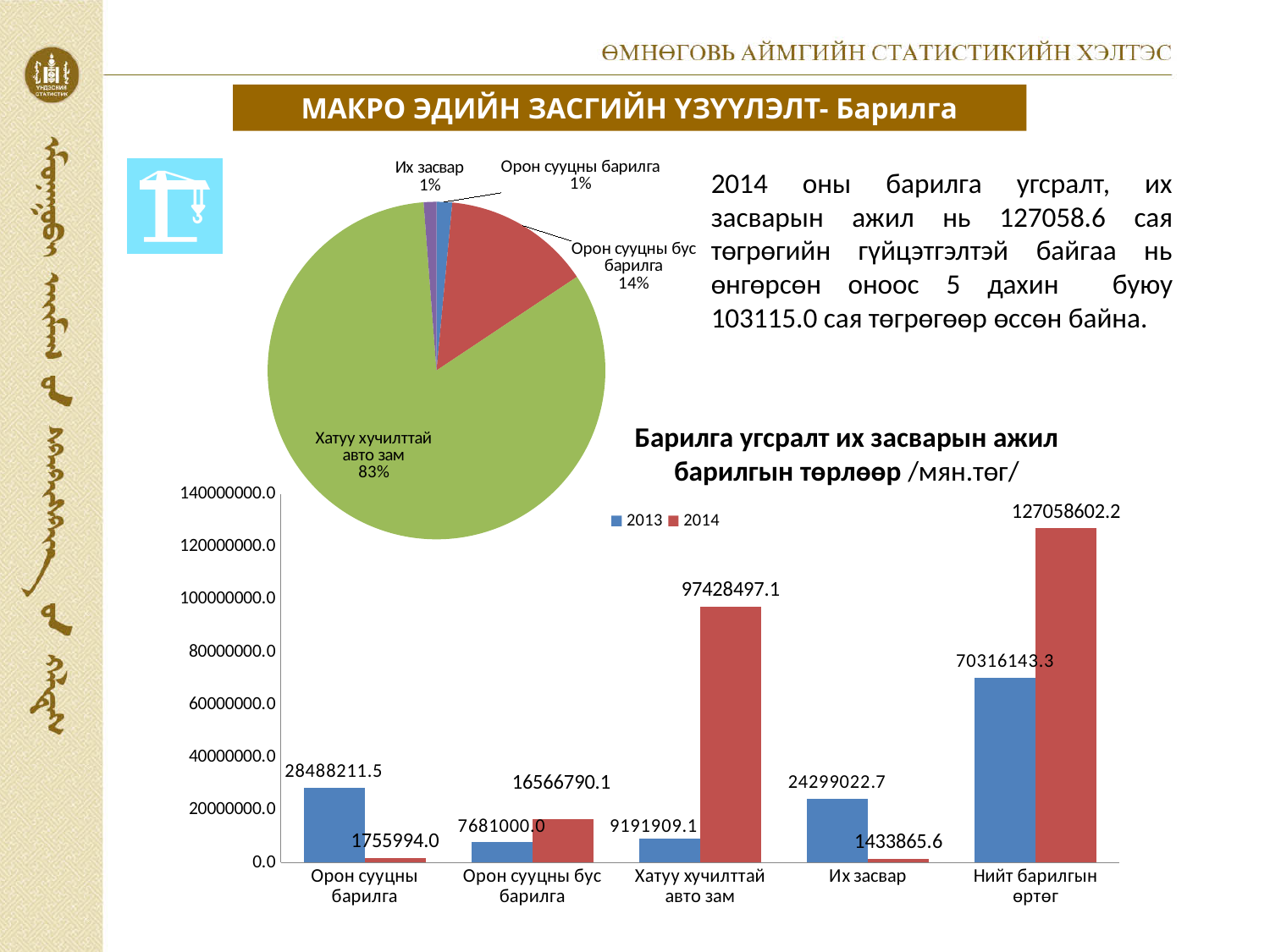
In the bar chart titled 'Барилга угсралт их засварын ажил барилгын төрлөөр', how many series does the legend list? 2 In the bar chart titled 'Барилга угсралт их засварын ажил барилгын төрлөөр', which is larger for Орон сууцны барилга: the 2013 value or the 2014 value? 2013 In the pie chart, what share does Орон сууцны бус барилга have? 14% What kind of chart is the one titled 'Барилга угсралт их засварын ажил барилгын төрлөөр'? Bar chart In the pie chart, what share does Хатуу хучилттай авто зам have? 83% In the bar chart titled 'Барилга угсралт их засварын ажил барилгын төрлөөр', what is the difference between the 2014 and 2013 values for Нийт барилгын өртөг? 56742458.9 In the pie chart, which slice is the largest? Хатуу хучилттай авто зам How many slices does the pie chart have? 4 In the bar chart titled 'Барилга угсралт их засварын ажил барилгын төрлөөр', which category has the lowest 2014 value? Их засвар In the bar chart titled 'Барилга угсралт их засварын ажил барилгын төрлөөр', what is the 2014 value for Хатуу хучилттай авто зам? 97428497.1 In the bar chart titled 'Барилга угсралт их засварын ажил барилгын төрлөөр', what is the 2014 value for Нийт барилгын өртөг? 127058602.2 In the bar chart titled 'Барилга угсралт их засварын ажил барилгын төрлөөр', what is the 2013 value for Их засвар? 24299022.7